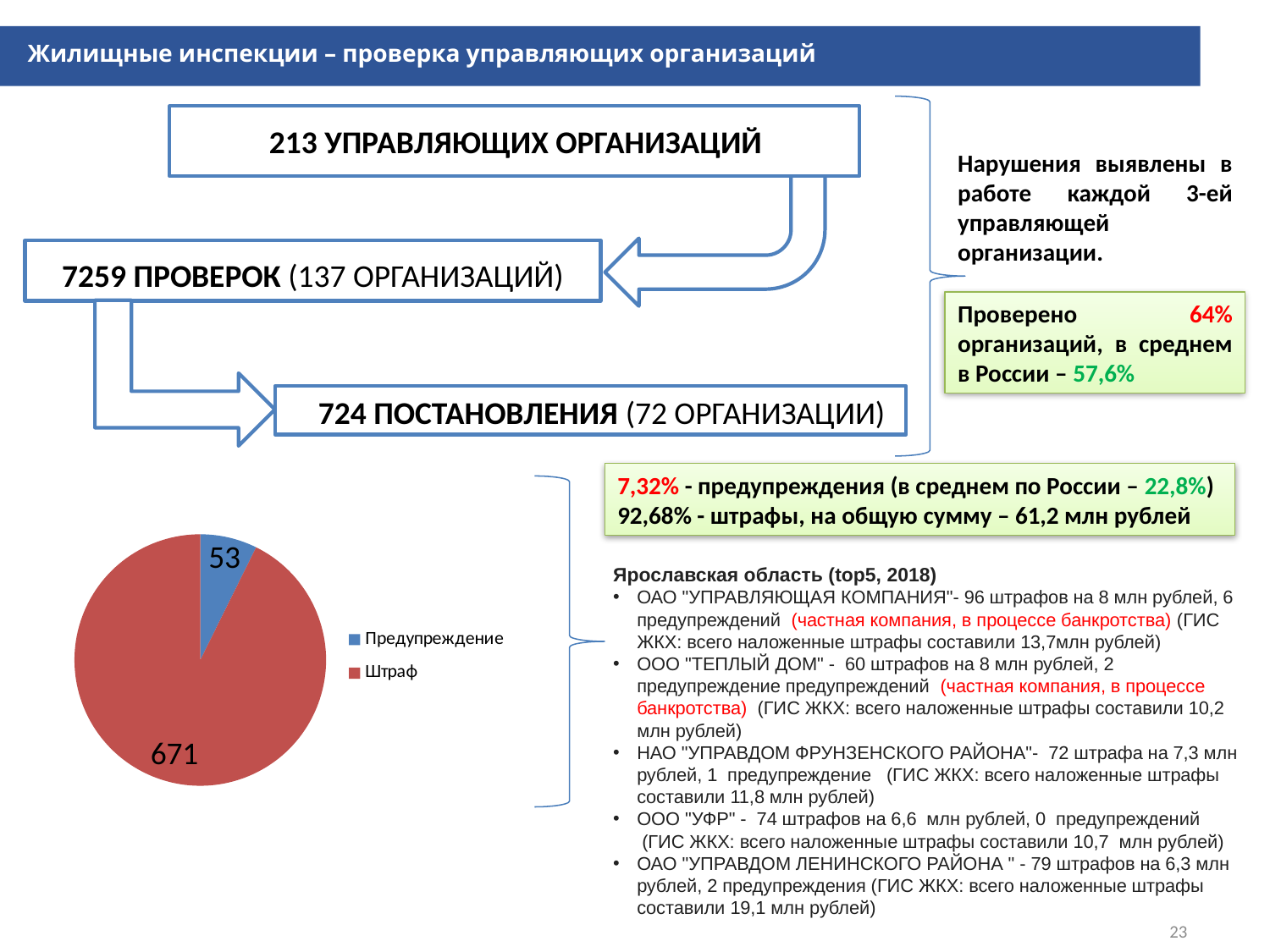
How many entries does the pie chart legend list? 2 What kind of chart is shown on the slide? pie chart How many slices does the pie chart have? 2 Which is larger in the pie chart, Предупреждение or Штраф? Штраф In the pie chart, what is the value for Штраф? 671 Which slice of the pie chart is the smallest? Предупреждение What colour is the Штраф slice in the pie chart? red Which slice of the pie chart is the largest? Штраф What is the total of the two values shown in the pie chart? 724 What is the difference between the Штраф and Предупреждение values in the pie chart? 618 In the pie chart, what is the value for Предупреждение? 53 What share of the pie does Предупреждение represent, as stated on the slide? 7,32%